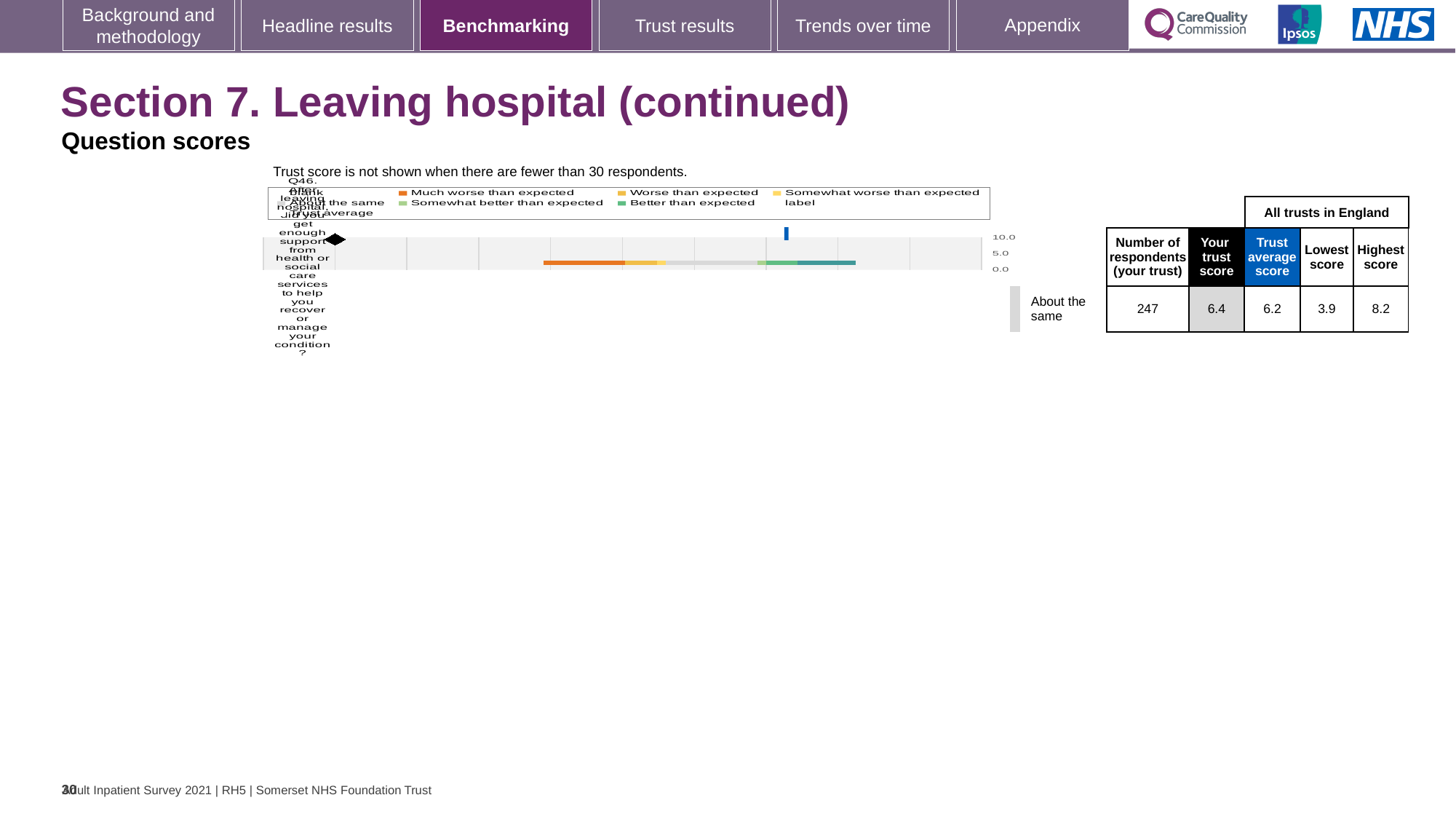
Which is larger for Q46: the trust score or the trust average score? The trust score (6.4) What colour represents 'Much worse than expected' in the chart legend? Orange What is the highest score among all trusts in England for Q46? 8.2 Is the trust score for Q46 greater or less than 5.0 on the chart axis? greater What is the difference between the trust score and the trust average score for Q46? 0.2 What is the difference between the highest and lowest scores for Q46 across all trusts in England? 4.3 Which benchmark category is the trust's Q46 score placed in? About the same What is the lowest score among all trusts in England for Q46? 3.9 What is the trust average score for Q46 across all trusts in England? 6.2 What is the trust score for Q46 (support from health or social care services after leaving hospital)? 6.4 How many respondents from the trust answered Q46? 247 What kind of chart is used to show the Q46 benchmarking result? Bar chart